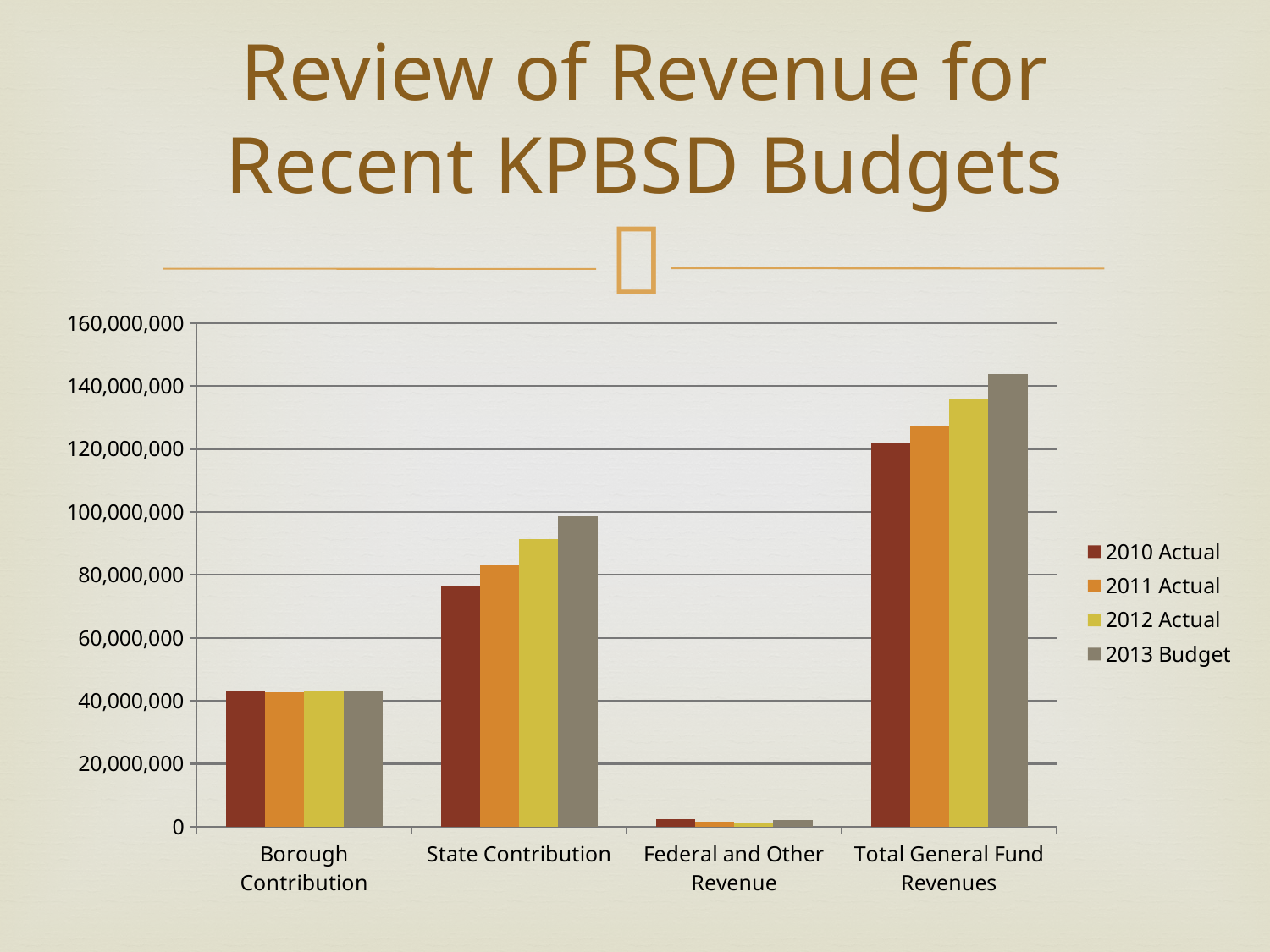
How many revenue categories are shown along the x axis? 4 What kind of chart is shown on the slide? Bar chart For State Contribution, which is larger: the 2010 Actual or the 2013 Budget value? 2013 Budget Is the 2013 Budget value for Total General Fund Revenues greater or less than 140,000,000? greater Which category has the lowest bars across all years? Federal and Other Revenue Is the 2010 Actual value for Borough Contribution greater or less than 40,000,000? greater What is the title of the slide containing the chart? Review of Revenue for Recent KPBSD Budgets Do the Total General Fund Revenues bars rise or fall from 2010 Actual to 2013 Budget? rise For 2011 Actual, which is larger: Borough Contribution or State Contribution? State Contribution Which category has the highest 2013 Budget bar? Total General Fund Revenues How many series does the legend list? 4 Is the 2012 Actual value for State Contribution greater or less than 100,000,000? less